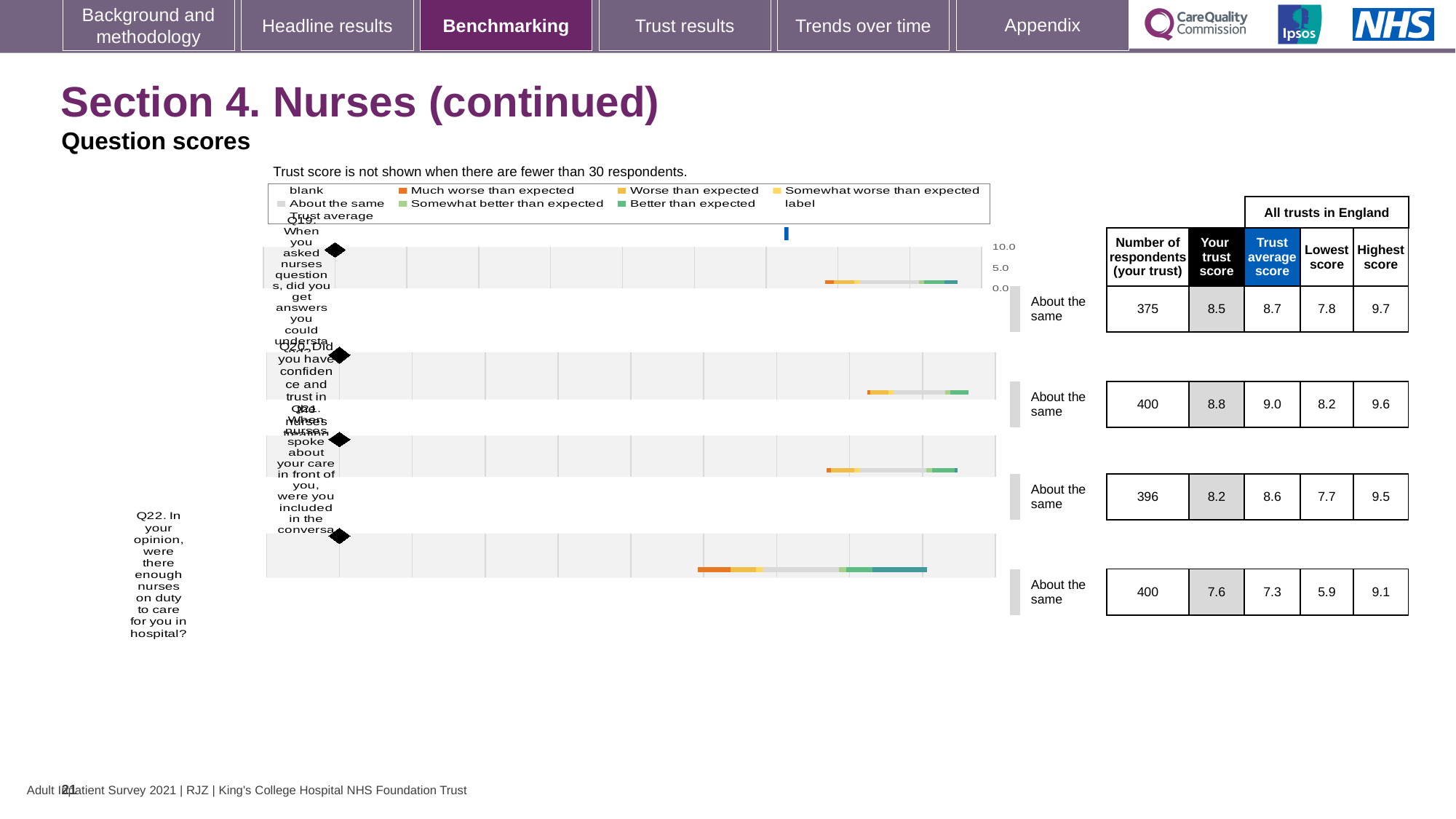
What is the maximum value shown on the chart's score axis? 10.0 What is your trust score for Q22 (In your opinion, were there enough nurses on duty to care for you in hospital)? 7.6 How many respondents from your trust answered Q19 (When you asked nurses questions, did you get answers you could understand)? 375 What is the trust average score for Q20 (Did you have confidence and trust in the nurses treating you)? 9.0 What benchmark category is shown for Q21? About the same What is the lowest score across all trusts in England for Q22? 5.9 For Q19, which is larger: your trust score or the trust average score? Trust average score What is the highest score across all trusts in England for Q21 (When nurses spoke about your care in front of you, were you included in the conversation)? 9.5 Which question has the highest 'Your trust score' on this slide? Q20 For Q22, what is the difference between your trust score and the trust average score? 0.3 How many questions are plotted on this slide? 4 Which question has the lowest 'Your trust score' on this slide? Q22